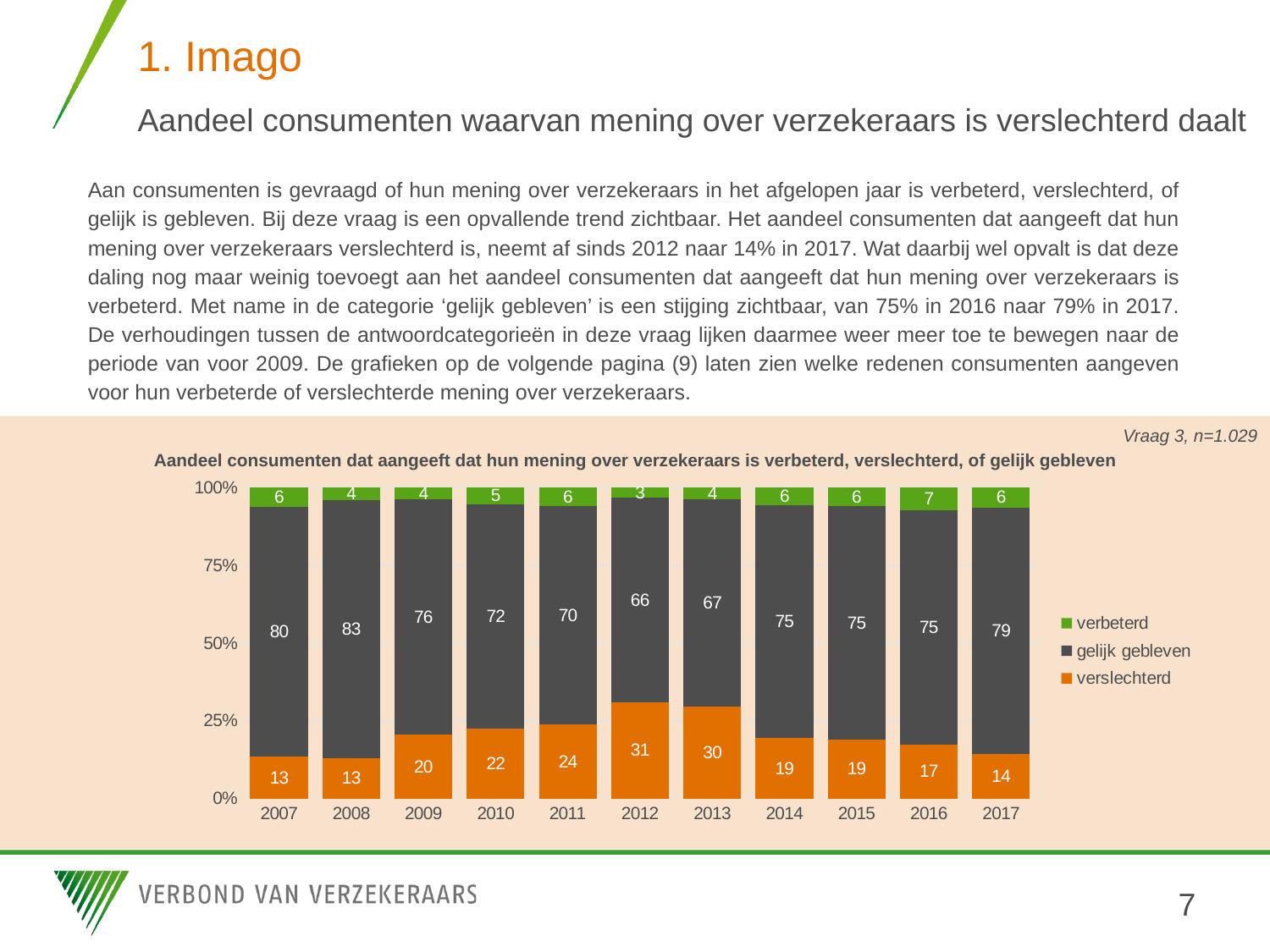
In which year is the 'verbeterd' value lowest? 2012 Which colour represents 'verslechterd' in the chart? orange What is the value for 'verslechterd' in 2012? 31 In which year is the 'verslechterd' value highest? 2012 How many series does the legend list? 3 What is the value for 'gelijk gebleven' in 2017? 79 How many years are shown on the x axis? 11 What is the difference between the 'verslechterd' values for 2012 and 2017? 17 What kind of chart is shown on the slide? stacked bar chart Which is larger: the 'gelijk gebleven' value for 2008 or for 2011? 2008 Does the 'verslechterd' value rise or fall from 2013 to 2017? fall What is the value for 'verbeterd' in 2016? 7